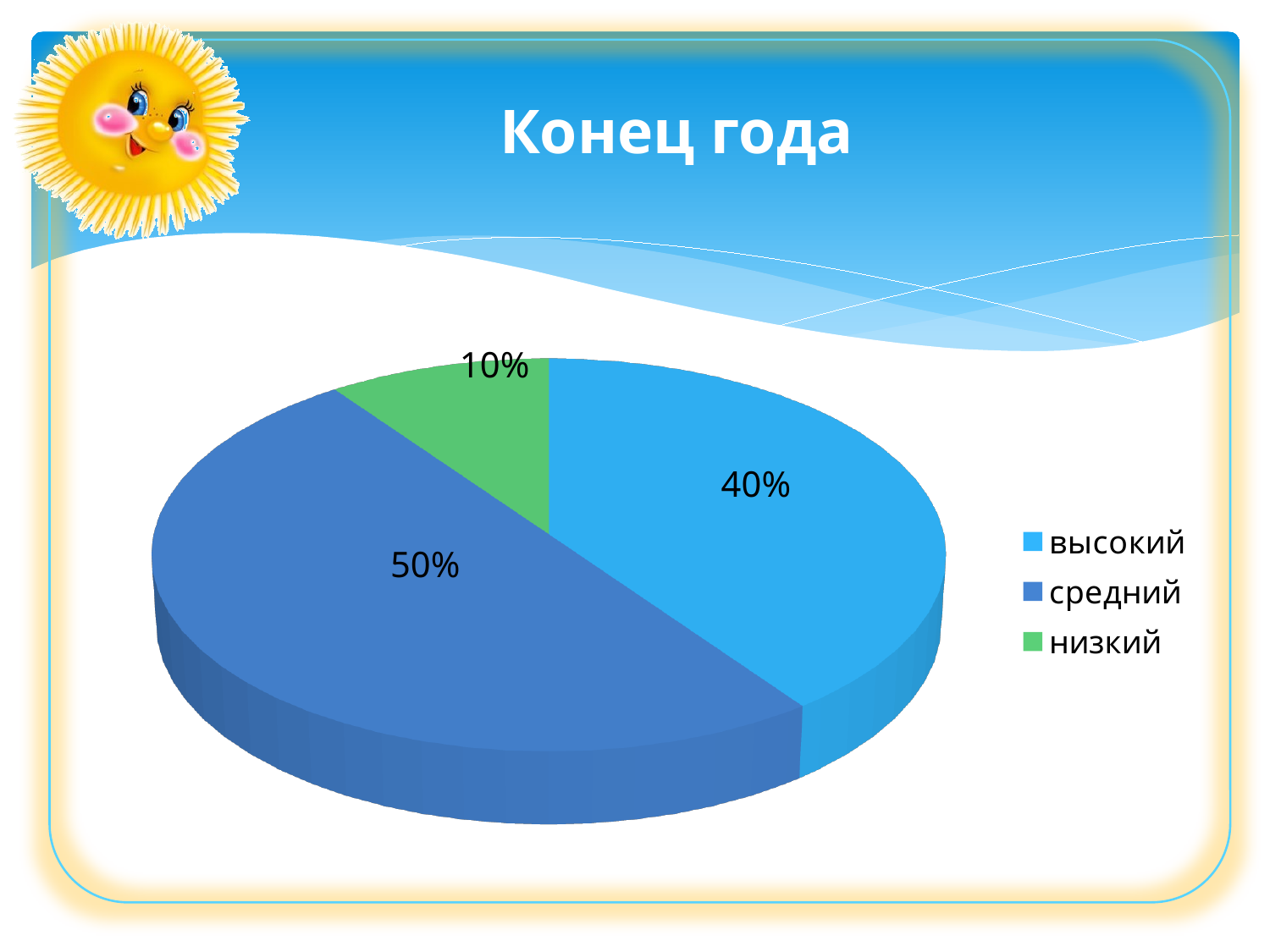
What is the title of the slide with the chart? Конец года How many slices does the pie chart have? 3 What is the value for средний? 50% Which is larger, the value for высокий or the value for низкий? высокий Which colour represents низкий in the legend? green What is the difference between the values for высокий and низкий? 30% Which category has the smallest share of the pie? низкий What is the value for низкий? 10% What kind of chart is shown on the slide? pie chart What is the difference between the values for средний and высокий? 10% Which category has the largest share of the pie? средний What is the value for высокий? 40%